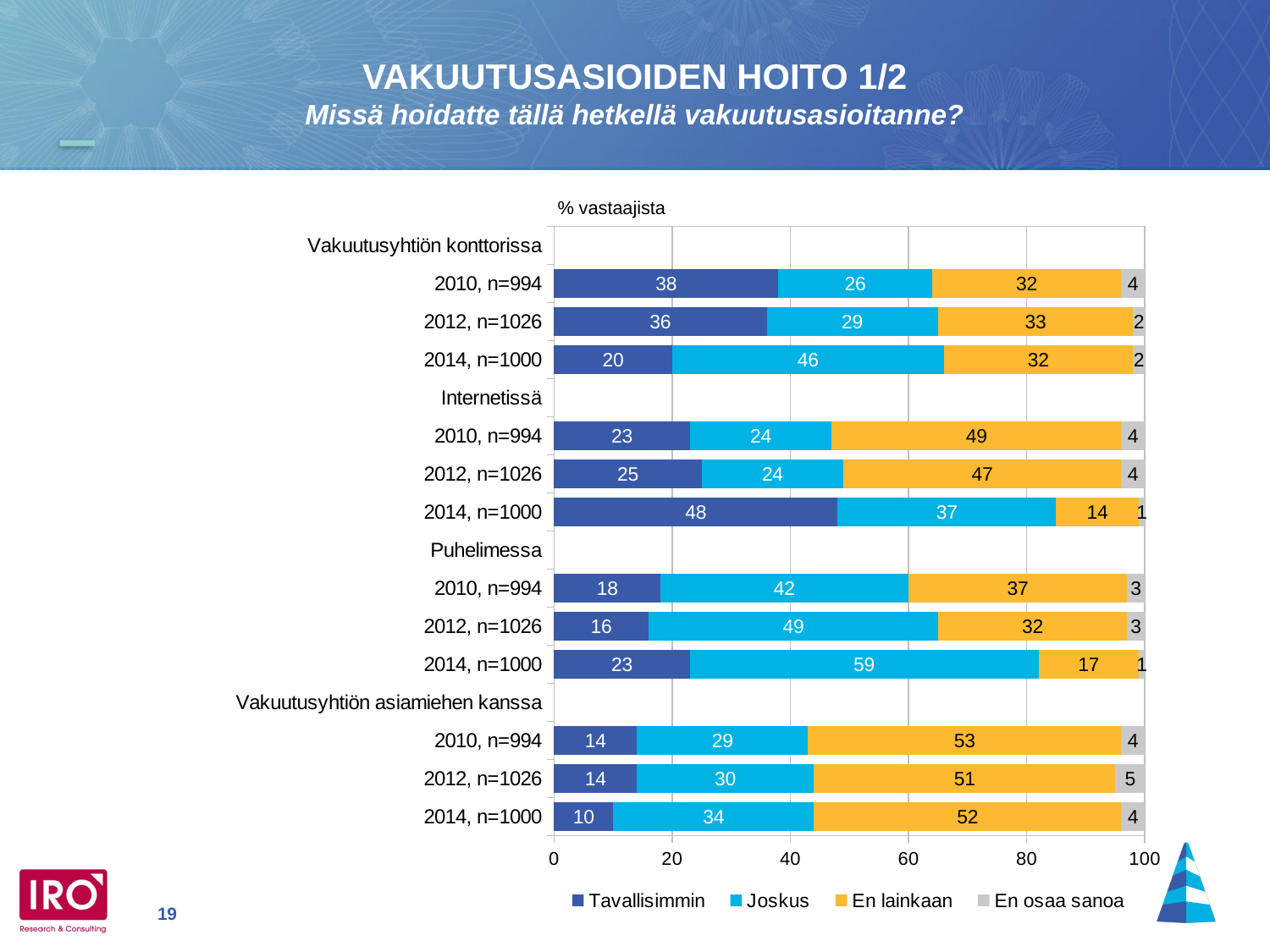
What is the label shown above the chart describing the unit of the values? % vastaajista What is the difference between the 'Joskus' values for Vakuutusyhtiön konttorissa in 2014, n=1000 and 2010, n=994? 20 What is the total of the stacked bar for Puhelimessa in 2012, n=1026? 100 Which year has the highest 'Tavallisimmin' value for Internetissä? 2014, n=1000 What is the 'En lainkaan' value for Vakuutusyhtiön asiamiehen kanssa in 2010, n=994? 53 What is the 'Joskus' value for Puhelimessa in 2014, n=1000? 59 Which is larger: the 'En lainkaan' value for Internetissä in 2010, n=994 or in 2014, n=1000? 2010, n=994 What is the 'Tavallisimmin' value for Vakuutusyhtiön konttorissa in 2014, n=1000? 20 How many series does the legend list? 4 What is the 'En osaa sanoa' value for Vakuutusyhtiön asiamiehen kanssa in 2012, n=1026? 5 What kind of chart is shown on the slide? stacked bar chart Which year has the lowest 'Tavallisimmin' value for Vakuutusyhtiön asiamiehen kanssa? 2014, n=1000